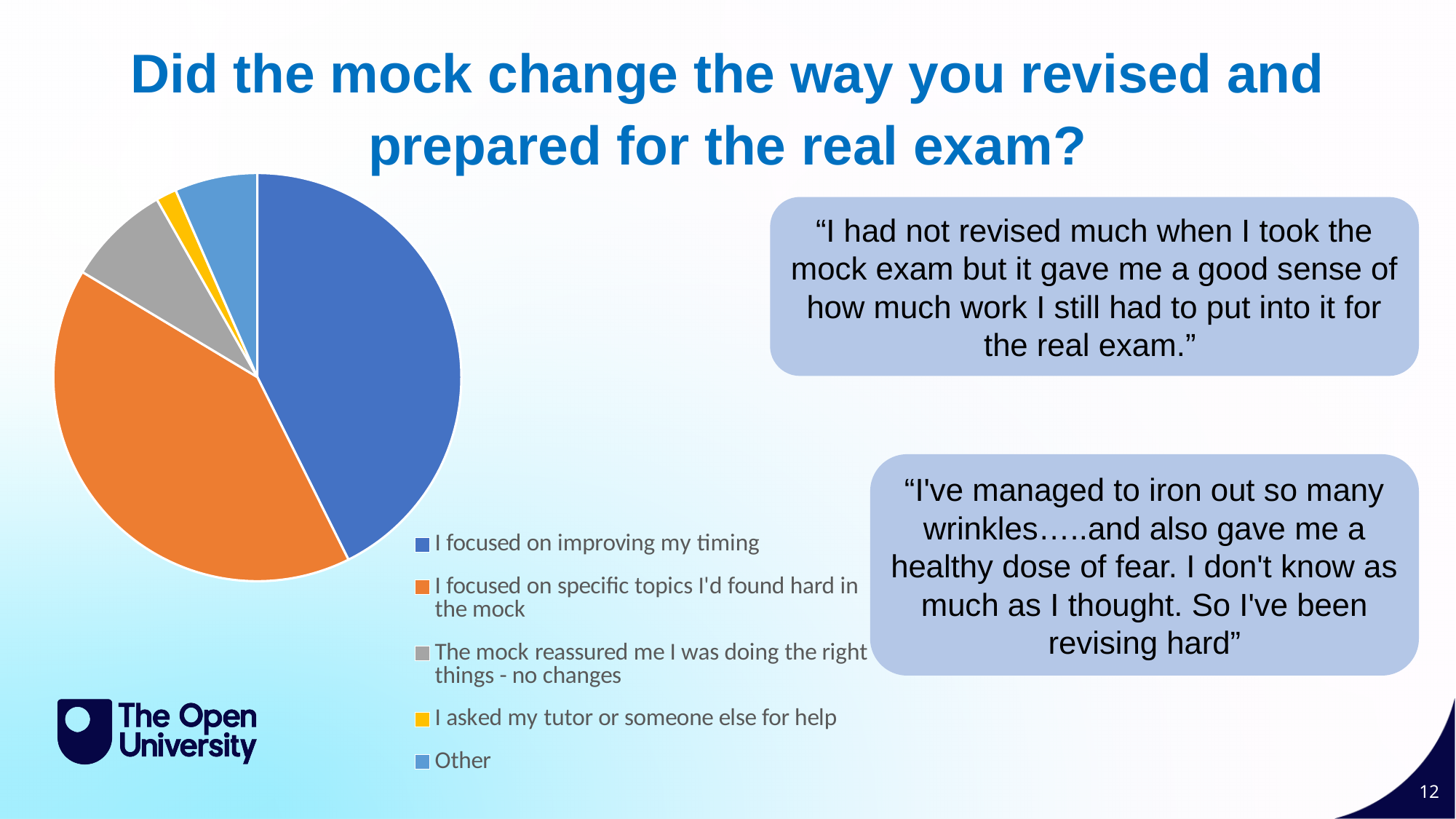
What colour is the slice for 'I focused on specific topics I'd found hard in the mock'? Orange What kind of chart is shown on the slide? Pie chart How many entries does the legend of the pie chart list? 5 Which legend entry is shown in yellow? I asked my tutor or someone else for help Which slice is larger: 'The mock reassured me I was doing the right things - no changes' or 'Other'? The mock reassured me I was doing the right things - no changes Which slice is larger: 'I focused on specific topics I'd found hard in the mock' or 'The mock reassured me I was doing the right things - no changes'? I focused on specific topics I'd found hard in the mock How many slices does the pie chart have? 5 Which response has the smallest slice of the pie chart? I asked my tutor or someone else for help Which response has the largest slice of the pie chart? I focused on improving my timing Which slice is larger: 'I asked my tutor or someone else for help' or 'Other'? Other